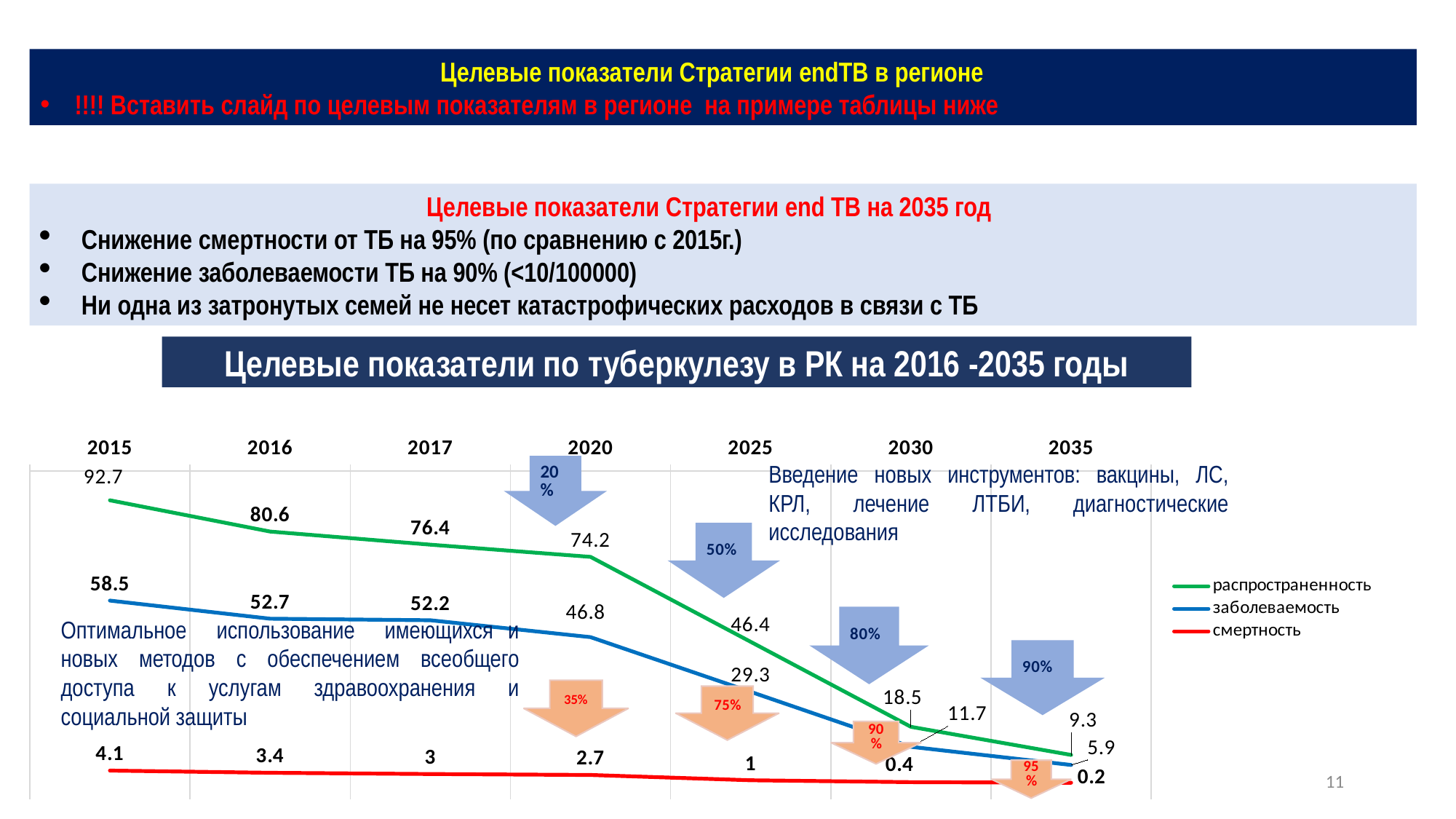
What is the value of распространенность in 2015? 92.7 What is the value of заболеваемость in 2025? 29.3 Do the values of смертность rise or fall from 2015 to 2035? fall Which is larger in 2030: распространенность or заболеваемость? распространенность In which year is заболеваемость lowest? 2035 In which year is распространенность highest? 2015 How many series does the chart legend list? 3 What type of chart is shown on the slide? line chart What is the value of смертность in 2035? 0.2 What is the difference between распространенность in 2015 and in 2035? 83.4 Which colour is used for the смертность series in the chart? red How many years are shown on the x axis of the chart? 7